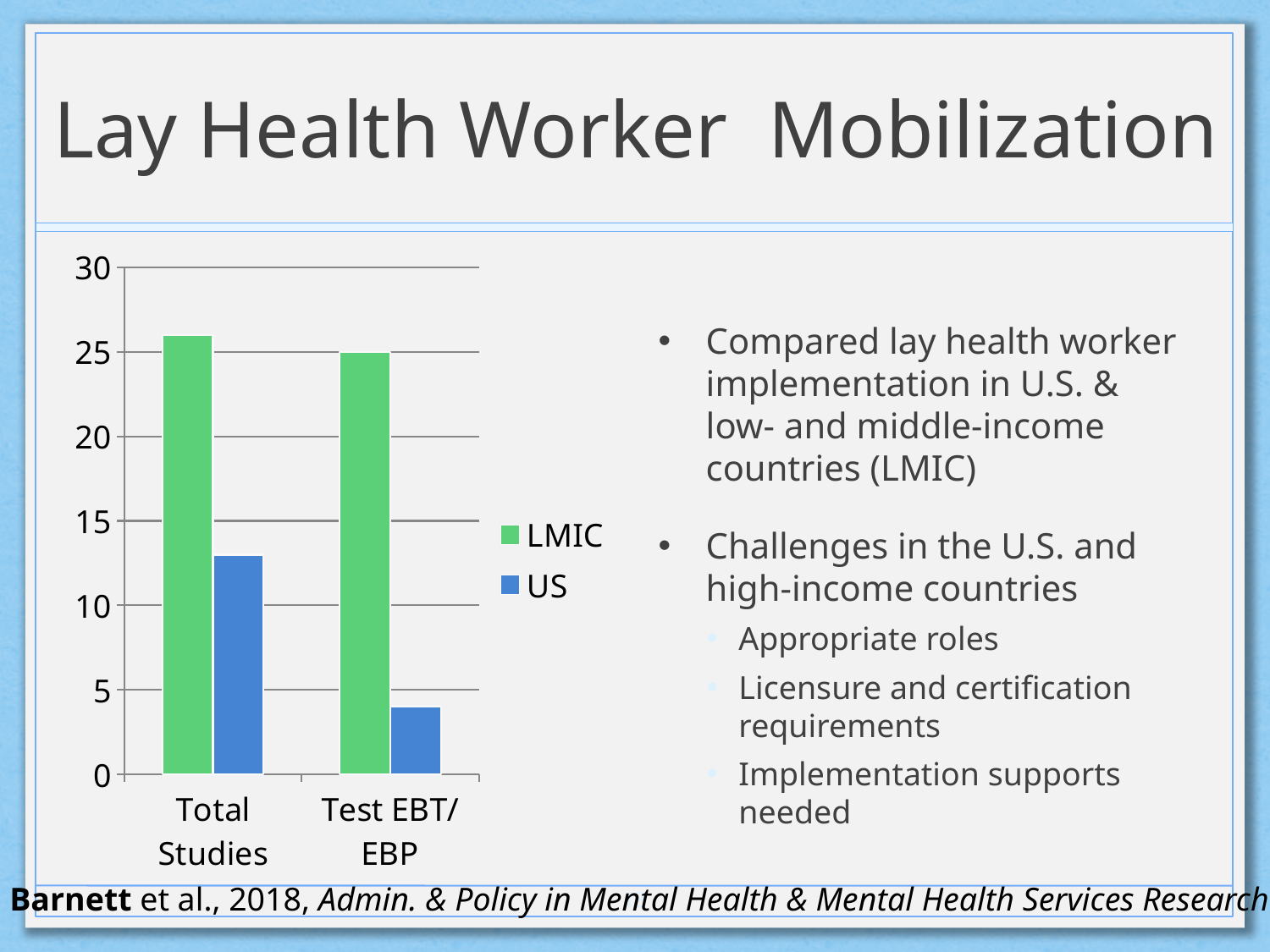
Which category has the lower US value, Total Studies or Test EBT/EBP? Test EBT/EBP What kind of chart is shown on the slide? bar chart Is the value of the US bar for Total Studies greater or less than 15? less Is the value of the US bar for Test EBT/EBP greater or less than 5? less Which series is shown in green in the chart? LMIC How many series does the chart legend list? 2 Is the value of the LMIC bar for Total Studies greater or less than 25? greater What is the value of the LMIC bar for Test EBT/EBP? 25 Which series has the higher value for Total Studies, LMIC or US? LMIC How many categories are shown on the x axis of the chart? 2 What is the maximum value shown on the chart's vertical axis? 30